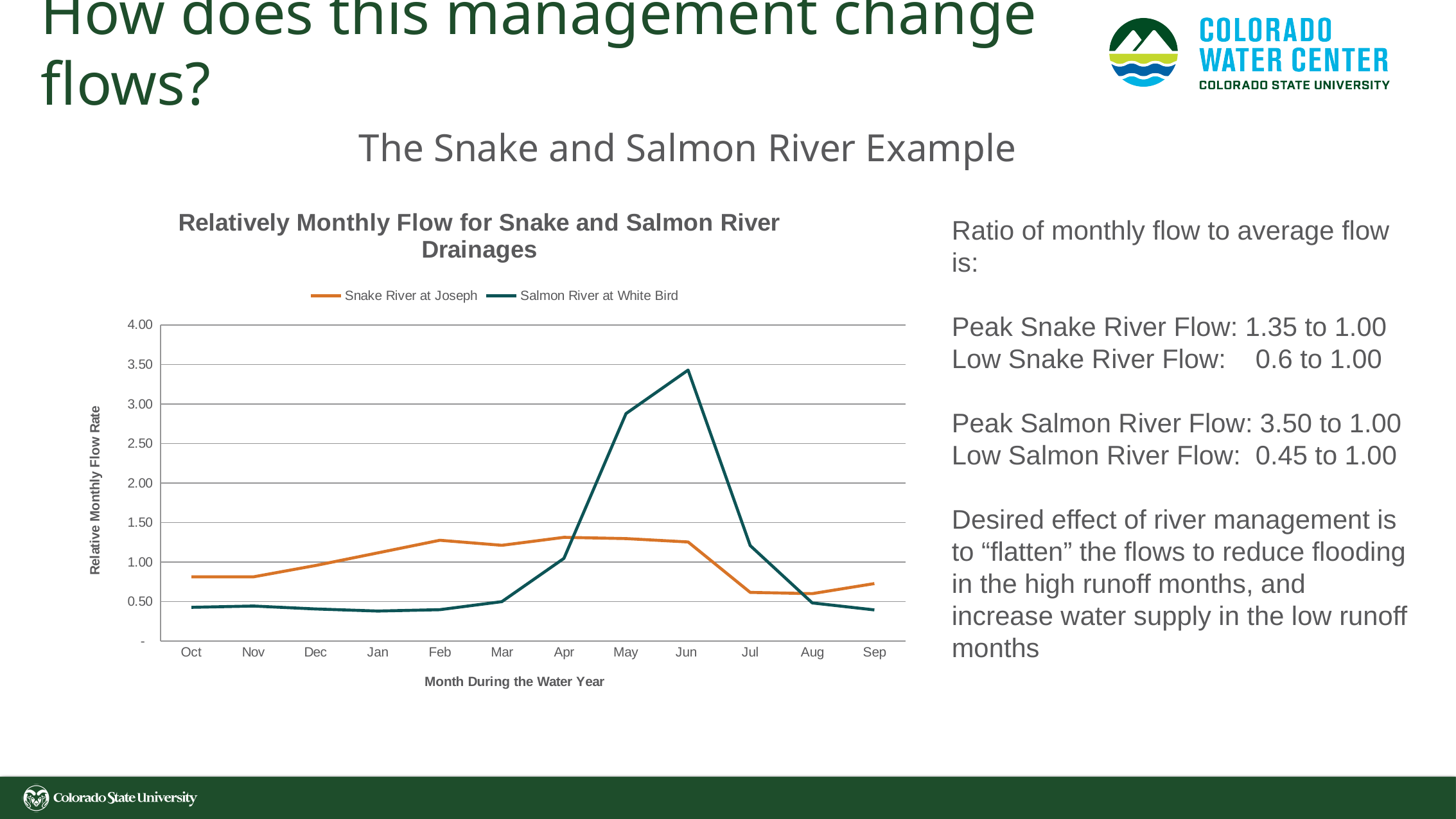
How many months are plotted along the x axis of the chart? 12 Is the value for Salmon River at White Bird in Jun greater or less than 3.00? greater Is the value for Salmon River at White Bird in May greater or less than 2.50? greater Is the value for Snake River at Joseph in Jul greater or less than 1.00? less In Jun, which series has the higher relative monthly flow rate, Snake River at Joseph or Salmon River at White Bird? Salmon River at White Bird How many series does the chart legend list? 2 Does the Salmon River at White Bird line rise or fall from Jun to Sep? fall In Feb, which series has the higher relative monthly flow rate, Snake River at Joseph or Salmon River at White Bird? Snake River at Joseph What is the label of the y axis of the chart? Relative Monthly Flow Rate In which month does the Salmon River at White Bird reach its highest relative monthly flow rate? Jun What kind of chart is shown on the slide? line chart